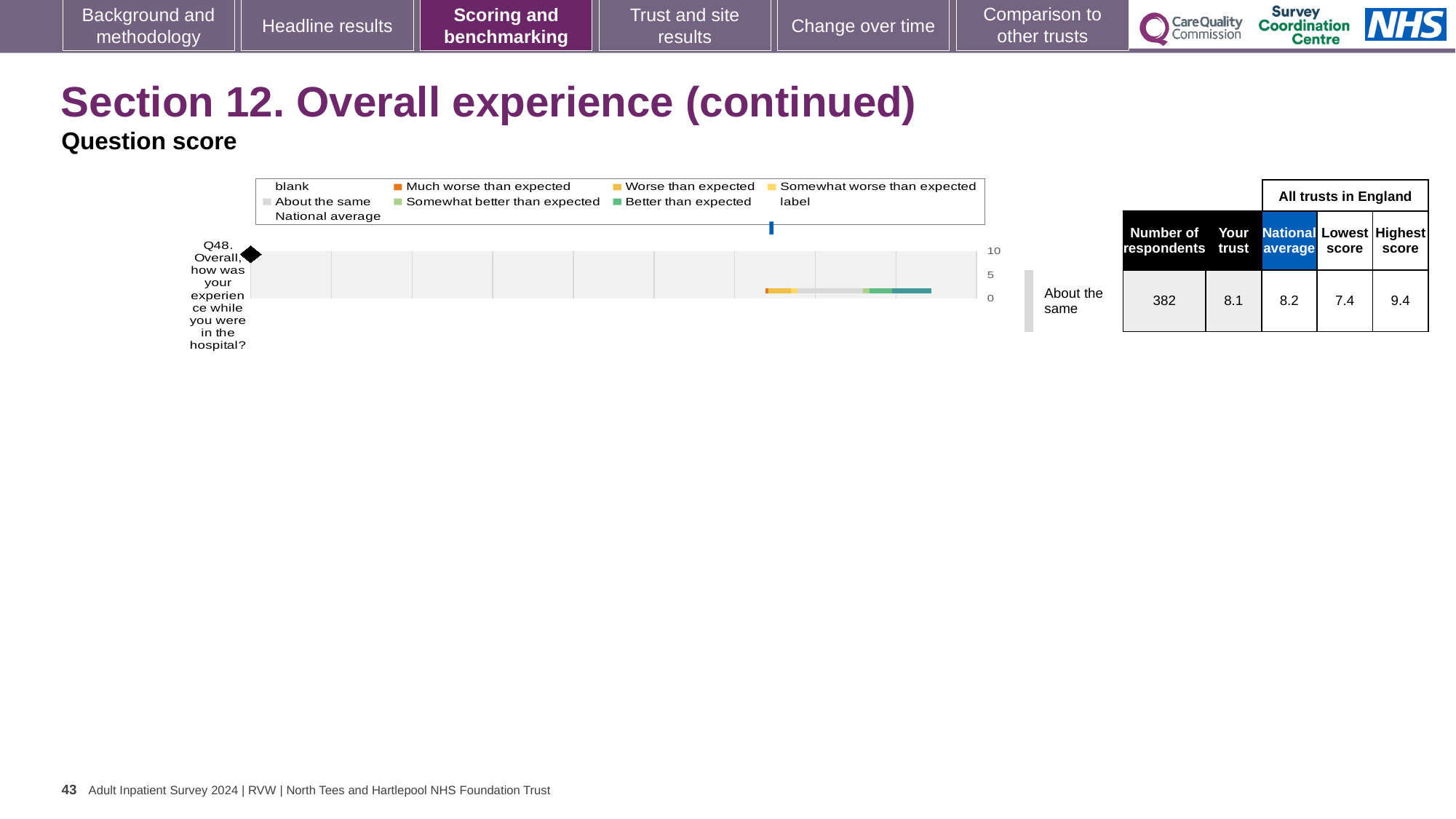
In the table next to the chart, what is the 'Your trust' score for Q48? 8.1 Which legend entry is shown in orange? Much worse than expected In the table next to the chart, what is the lowest score among all trusts in England for Q48? 7.4 What is the highest value shown on the chart's axis? 10 What kind of chart is shown on the slide? bar chart In the table next to the chart, what is the highest score among all trusts in England for Q48? 9.4 What is the difference between the highest score and the lowest score for Q48 in the table? 2.0 Which question is plotted on the chart? Q48. Overall, how was your experience while you were in the hospital? Which is larger for Q48: the 'Your trust' score or the national average? National average How many questions (categories) are plotted on the chart? 1 In the table next to the chart, what is the number of respondents for Q48? 382 In the table next to the chart, what is the national average score for Q48? 8.2